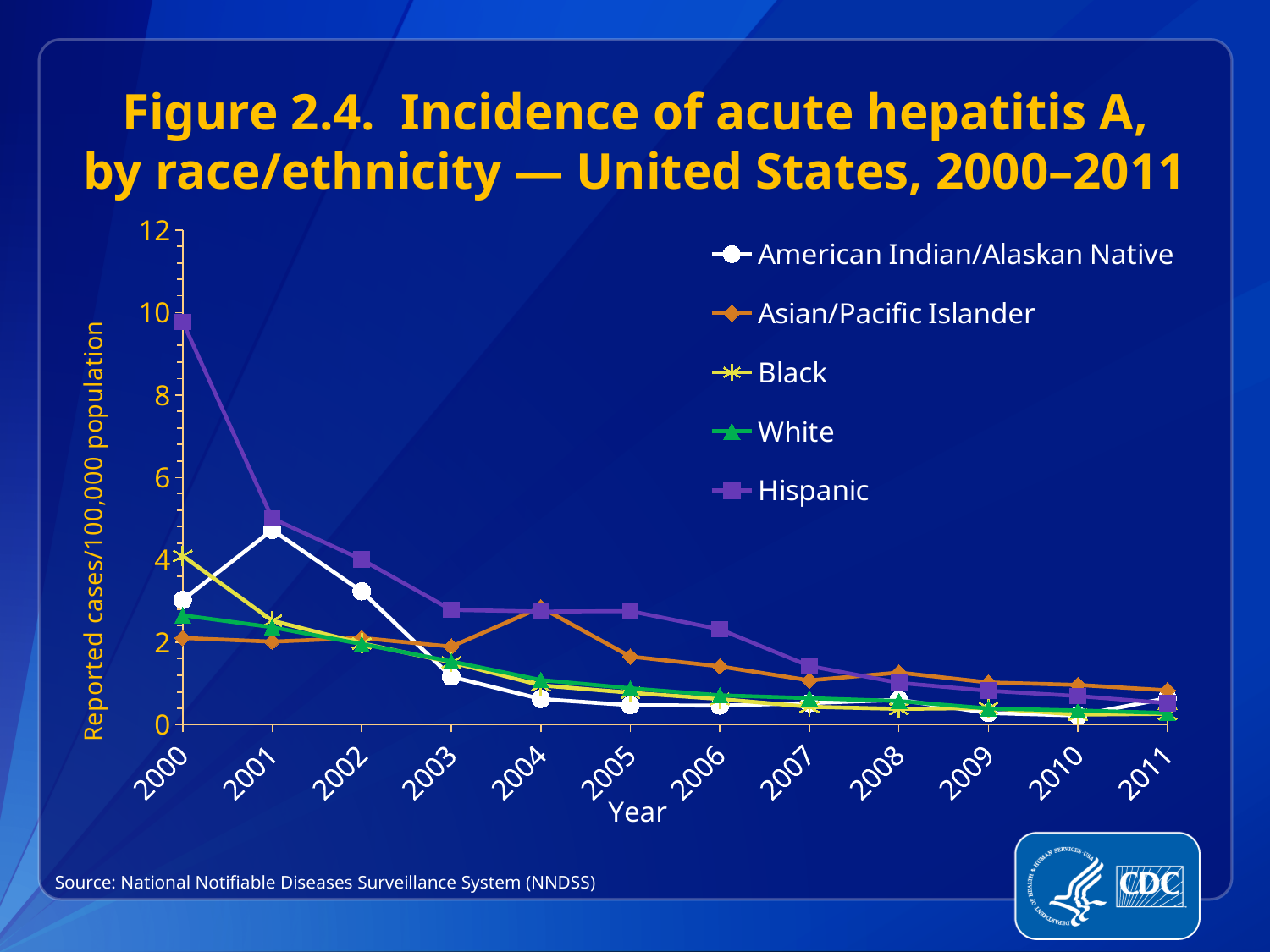
Is the value for Hispanic in 2000 greater or less than 8? greater Which race/ethnicity group had the highest incidence in 2002? Hispanic How many years are plotted along the x axis? 12 Is the value for American Indian/Alaskan Native in 2003 greater or less than 2? less Is the value for Asian/Pacific Islander in 2004 greater or less than 2? greater How many series does the legend list? 5 Which is larger in 2000, the value for Hispanic or the value for White? Hispanic What is the label on the y axis? Reported cases/100,000 population What kind of chart is shown on the slide? line chart Does the incidence for Hispanic rise or fall from 2000 to 2011? fall Which race/ethnicity group had the highest incidence in 2000? Hispanic